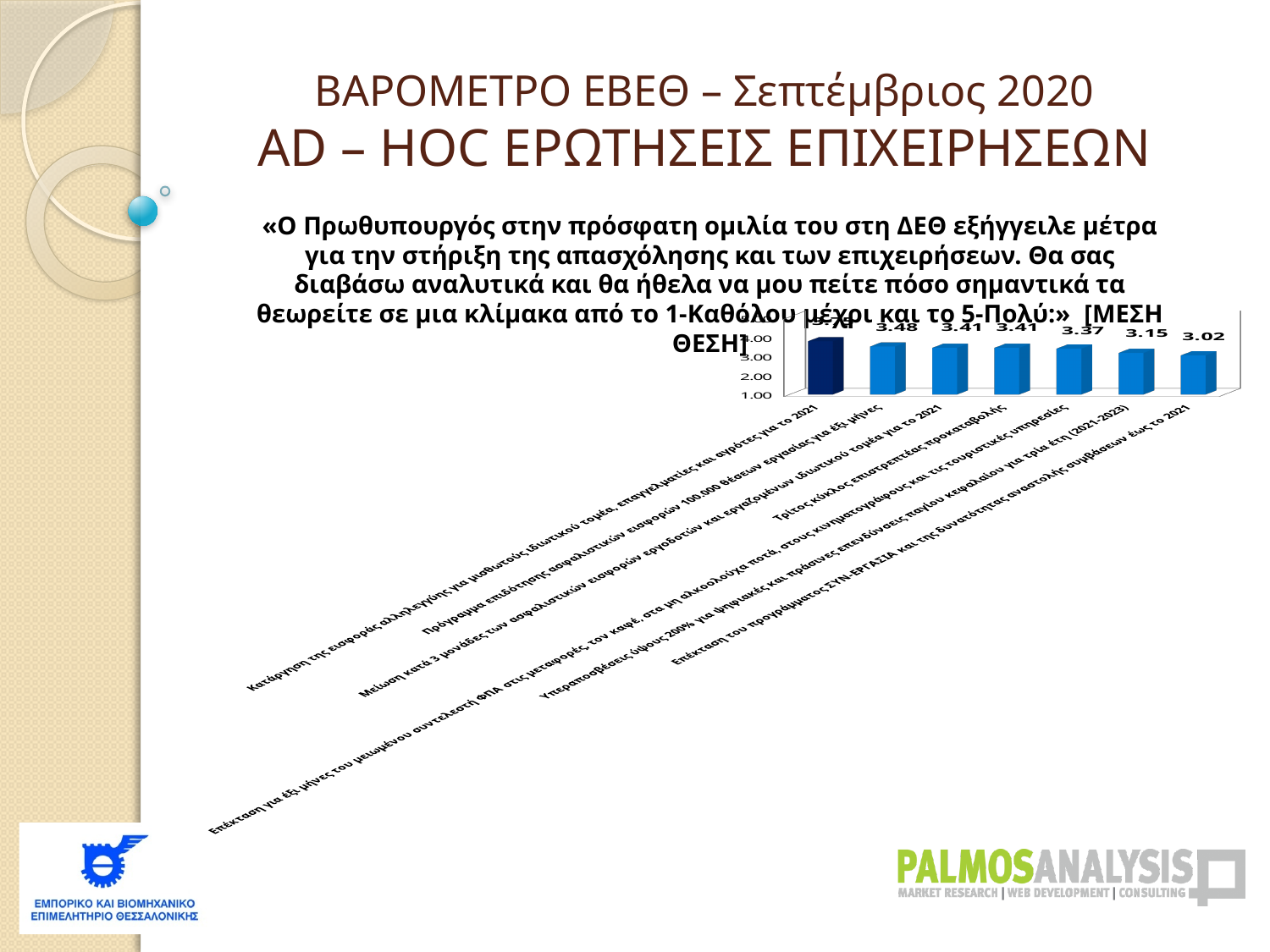
How many measures (bars) are plotted in the chart? 7 Do the values rise or fall moving from left to right along the x axis? Fall What is the mean score for the measure about extending the reduced VAT rate for six months (Επέκταση για έξι μήνες του μειωμένου συντελεστή ΦΠΑ)? 3.37 What is the mean score for 'Υπεραποσβέσεις ύψους 200% για ψηφιακές και πράσινες επενδύσεις'? 3.15 Which has a higher mean score: 'Υπεραποσβέσεις ύψους 200%' or 'Επέκταση για έξι μήνες του μειωμένου συντελεστή ΦΠΑ'? Επέκταση για έξι μήνες του μειωμένου συντελεστή ΦΠΑ What is the difference between the mean score for 'Πρόγραμμα επιδότησης ασφαλιστικών εισφορών 100.000 θέσεων εργασίας' and the score for 'Επέκταση του προγράμματος ΣΥΝ-ΕΡΓΑΣΙΑ'? 0.46 Which measure has the lowest mean score? Επέκταση του προγράμματος ΣΥΝ-ΕΡΓΑΣΙΑ και της δυνατότητας αναστολής συμβάσεων έως το 2021 What is the mean score for 'Τρίτος κύκλος επιστρεπτέας προκαταβολής'? 3.41 What is the mean score for 'Πρόγραμμα επιδότησης ασφαλιστικών εισφορών 100.000 θέσεων εργασίας για έξι μήνες'? 3.48 What kind of chart is shown on the slide? Bar chart What is the mean score for 'Επέκταση του προγράμματος ΣΥΝ-ΕΡΓΑΣΙΑ και της δυνατότητας αναστολής συμβάσεων έως το 2021'? 3.02 Which measure has the highest mean score? Κατάργηση της εισφοράς αλληλεγγύης για μισθωτούς ιδιωτικού τομέα, επαγγελματίες και αγρότες για το 2021